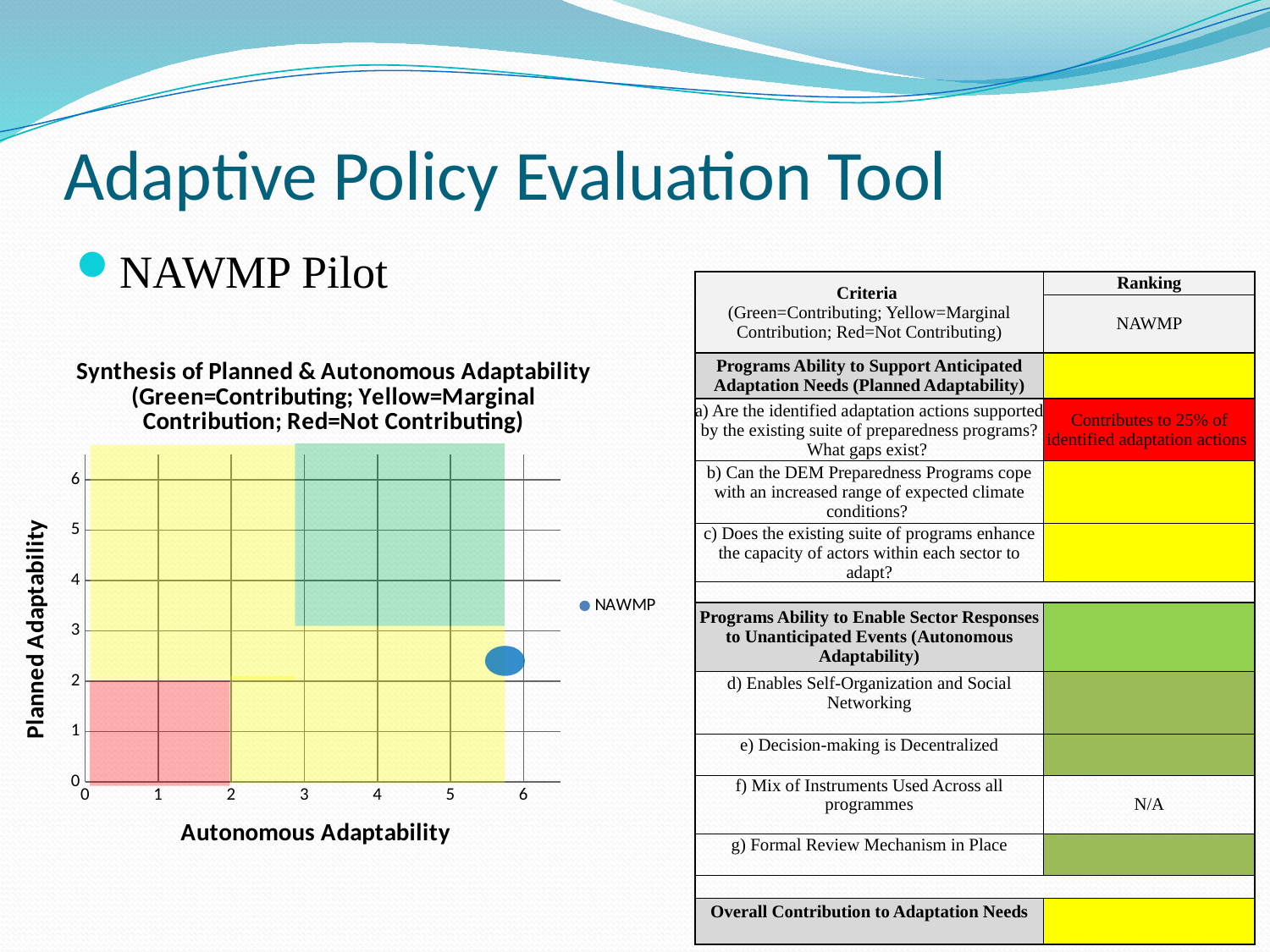
Is the Planned Adaptability value for the NAWMP point greater or less than 3? less What is the highest tick value shown on the chart's vertical axis? 6 What kind of chart is shown on the slide? scatter chart What is the name of the series shown in the chart's legend? NAWMP How many data points are plotted on the chart? 1 What is the title of the chart's horizontal axis? Autonomous Adaptability Is the Autonomous Adaptability value for the NAWMP point greater or less than 4? greater How many series does the chart's legend list? 1 Is the Autonomous Adaptability value for the NAWMP point greater or less than 5? greater